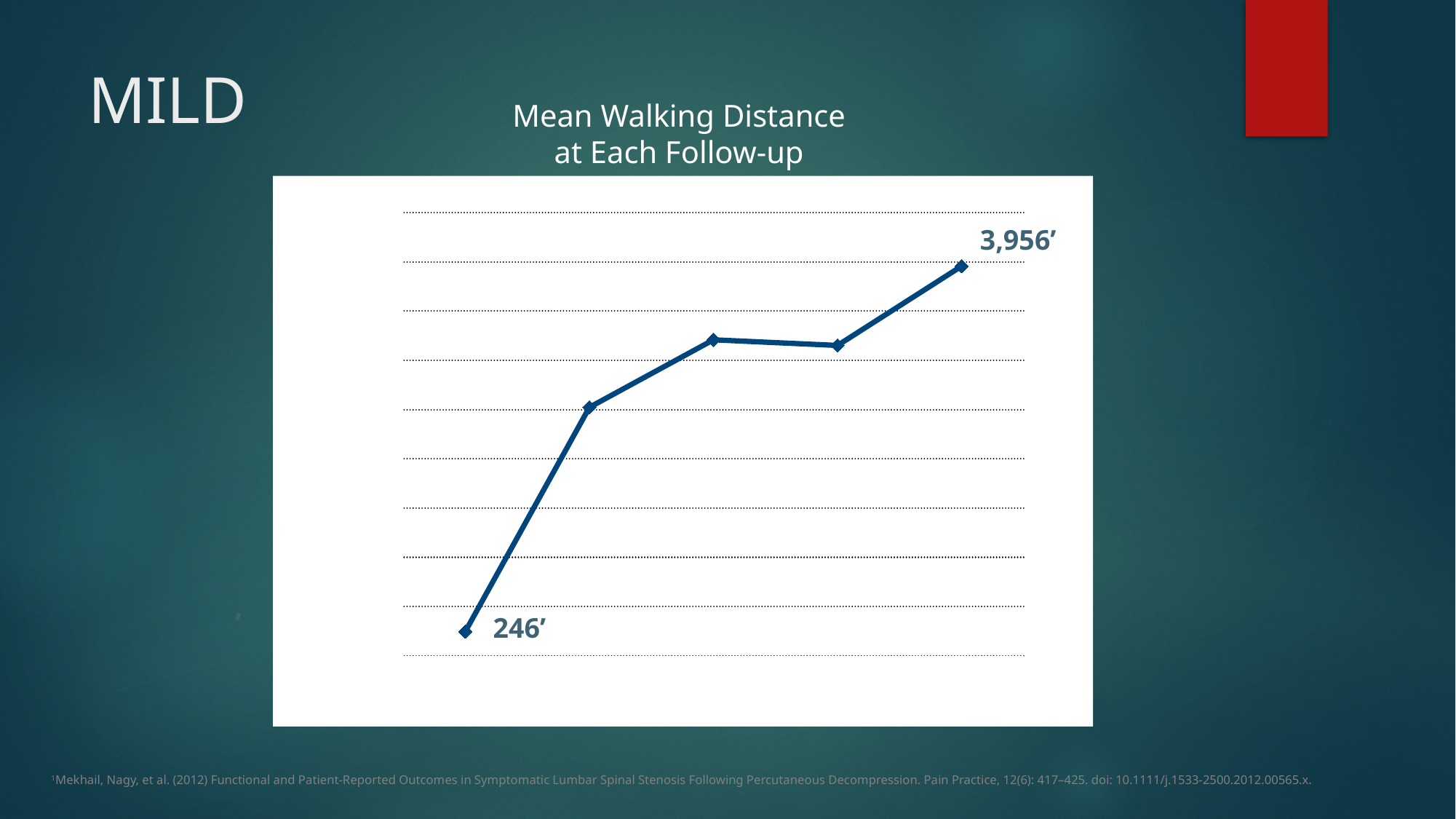
Overall, does the mean walking distance rise or fall from the first follow-up to the last? Rise Which point on the line has the lowest value? The first point (246’) How many series are plotted on the chart? 1 What is the difference between the last labelled value (3,956’) and the first labelled value (246’)? 3,710’ What kind of chart is shown on the slide? Line chart What is the value labelled at the last point of the line? 3,956’ What colour is the plotted line? Dark blue What is the value labelled at the first point of the line? 246’ Which point on the line has the highest value? The last point (3,956’) How many data points are plotted on the line? 5 Which is larger, the first point or the last point on the line? The last point What is the title of the chart? Mean Walking Distance at Each Follow-up